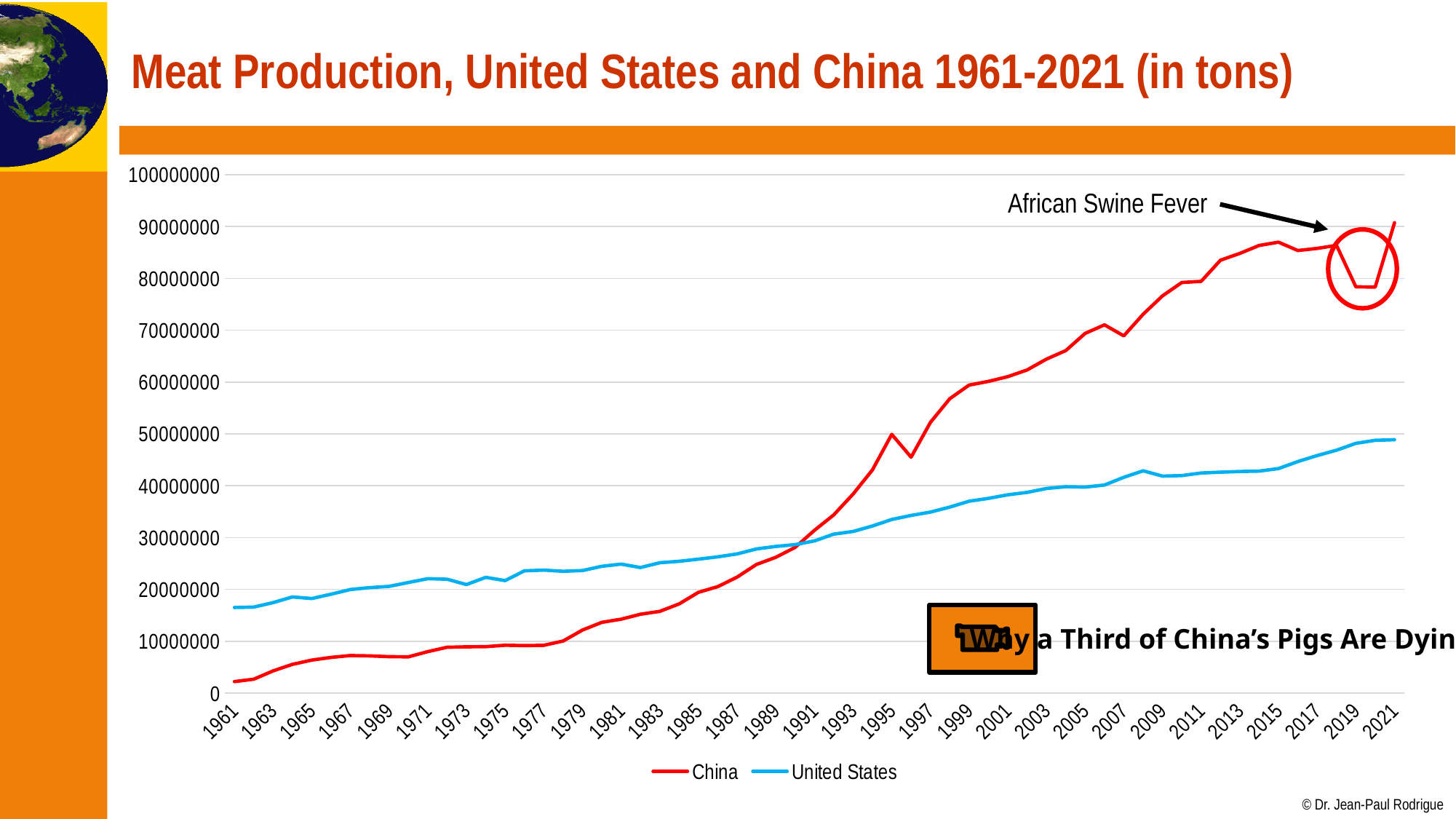
Which series has the larger value in 2021, China or the United States? China Which series has the larger value in 1961, China or the United States? United States Does the United States series generally rise or fall from 1961 to 2021? Rise Is the value for the United States in 2009 greater or less than 40000000? greater Is the value for the United States in 1961 greater or less than 20000000? less How many series does the legend list? 2 What event does the annotation with the arrow and circle point to on the China line? African Swine Fever What kind of chart is shown on the slide? Line chart Is the value for China in 1961 greater or less than 10000000? less Which two series are listed in the legend? China and United States